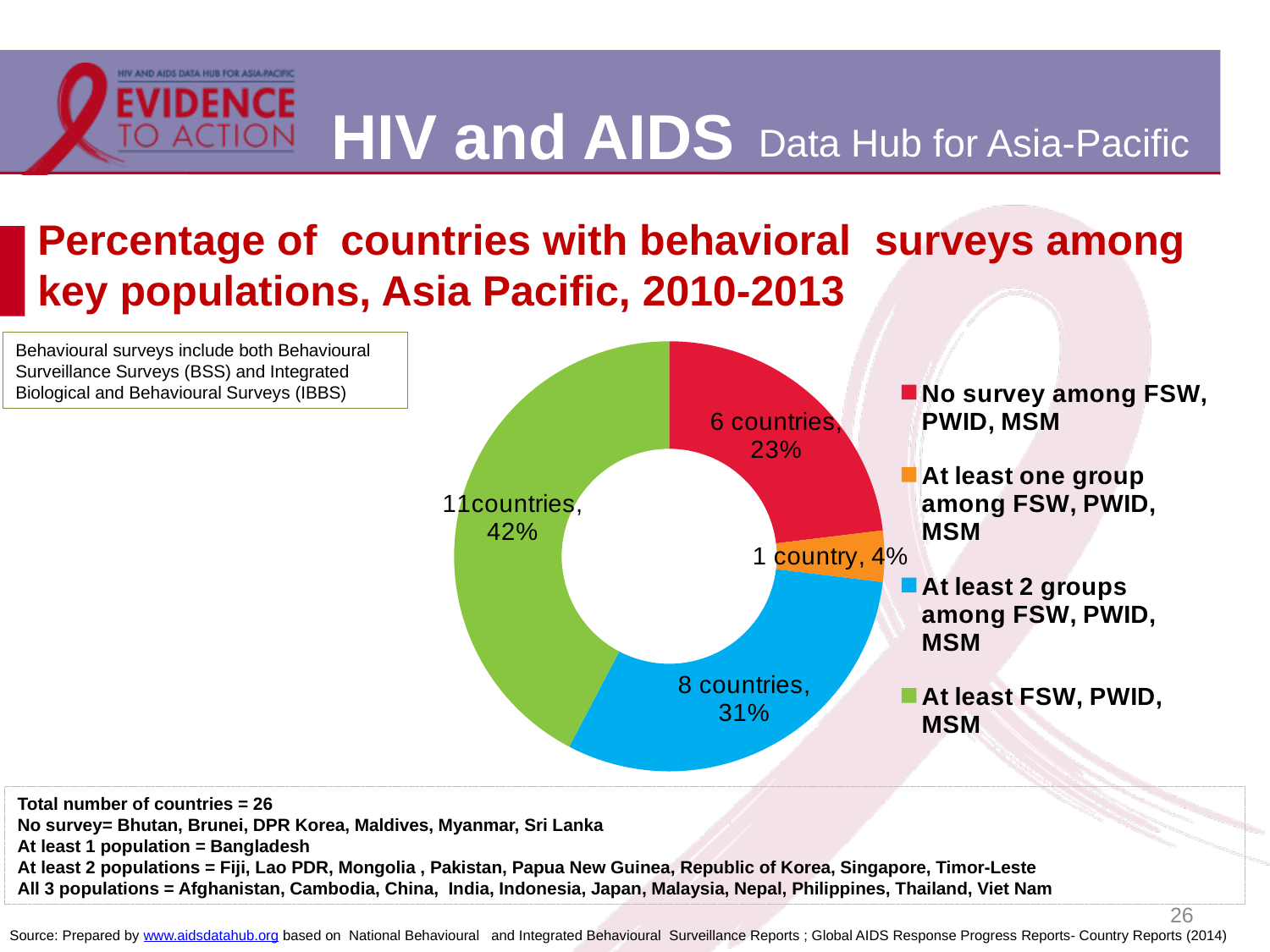
How many categories does the chart show? 4 What colour is the slice for 'No survey among FSW, PWID, MSM'? Red Which category has the largest share of the chart? At least FSW, PWID, MSM How many countries had no survey among FSW, PWID, MSM? 6 countries What percentage of countries had surveys among at least 2 groups among FSW, PWID, MSM? 31% How many countries had a survey among at least one group among FSW, PWID, MSM? 1 country How many more countries had surveys among at least FSW, PWID, MSM than had no survey? 5 Which category has the smallest share of the chart? At least one group among FSW, PWID, MSM What percentage of countries had surveys among at least FSW, PWID, MSM? 42% What is the difference in percentage points between the 'At least FSW, PWID, MSM' slice and the 'At least 2 groups' slice? 11 percentage points What kind of chart is shown on the slide? Doughnut (pie) chart Which is larger: the share of countries with no survey or the share with surveys among at least 2 groups? At least 2 groups